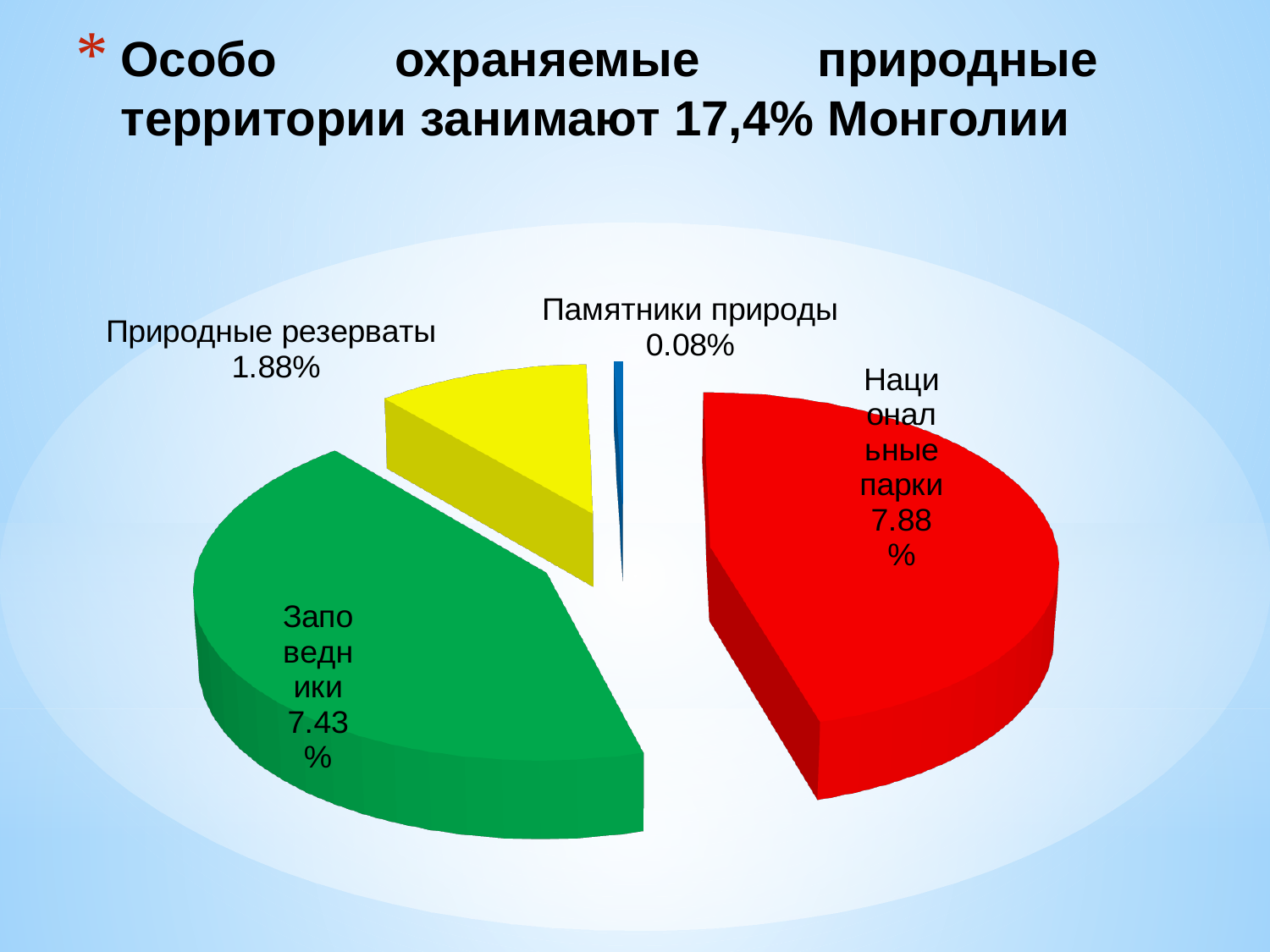
What value is shown for Заповедники? 7.43% Which is larger, the value for Национальные парки or the value for Заповедники? Национальные парки What value is shown for Памятники природы? 0.08% How many slices does the pie chart have? 4 What value is shown for Природные резерваты? 1.88% What value is shown for Национальные парки? 7.88% What is the difference between the values for Национальные парки and Заповедники? 0.45% What colour is the slice for Заповедники? green What is the difference between the values for Заповедники and Природные резерваты? 5.55% Which category has the smallest value in the pie chart? Памятники природы Which category has the largest value in the pie chart? Национальные парки What kind of chart is shown on the slide? pie chart